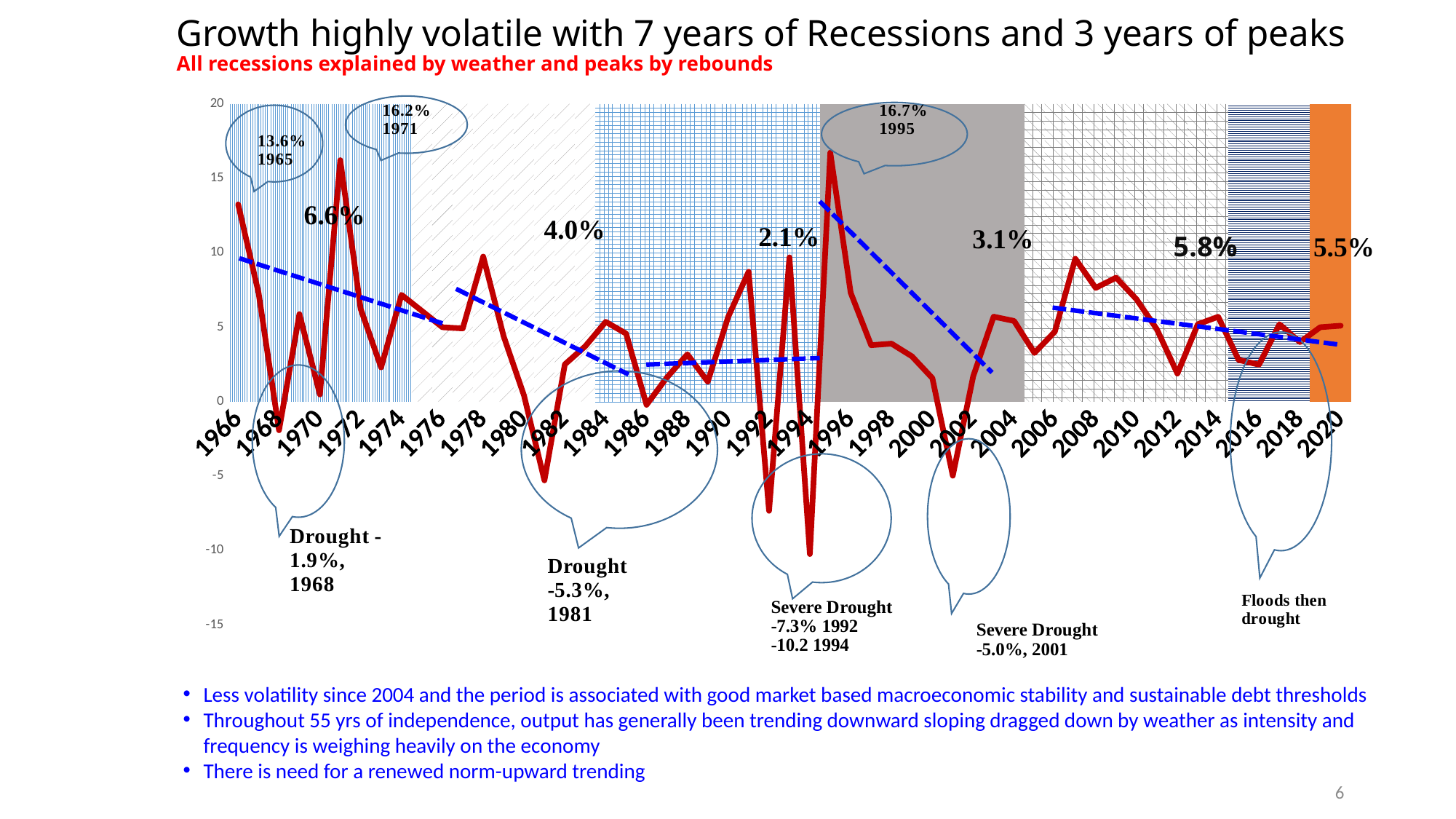
Which is larger, the annotated growth rate for 1971 or for 1995? 1995 Which year has the highest growth rate on the chart? 1995 What growth rate is annotated for the 2001 severe drought? -5.0% What growth rate is annotated for 1995? 16.7% What is the difference between the annotated growth rates for 1992 (-7.3%) and 1994 (-10.2)? 2.9 What growth rate is annotated for the 1994 severe drought? -10.2 What kind of chart is shown on the slide? line chart Is the growth rate for 1978 greater or less than 5? greater What growth rate is annotated for 1971? 16.2% Which year has the lowest growth rate on the chart? 1994 What growth rate is annotated for the 1981 drought? -5.3% What is the average growth rate label shown for the first shaded period (1966-1974)? 6.6%